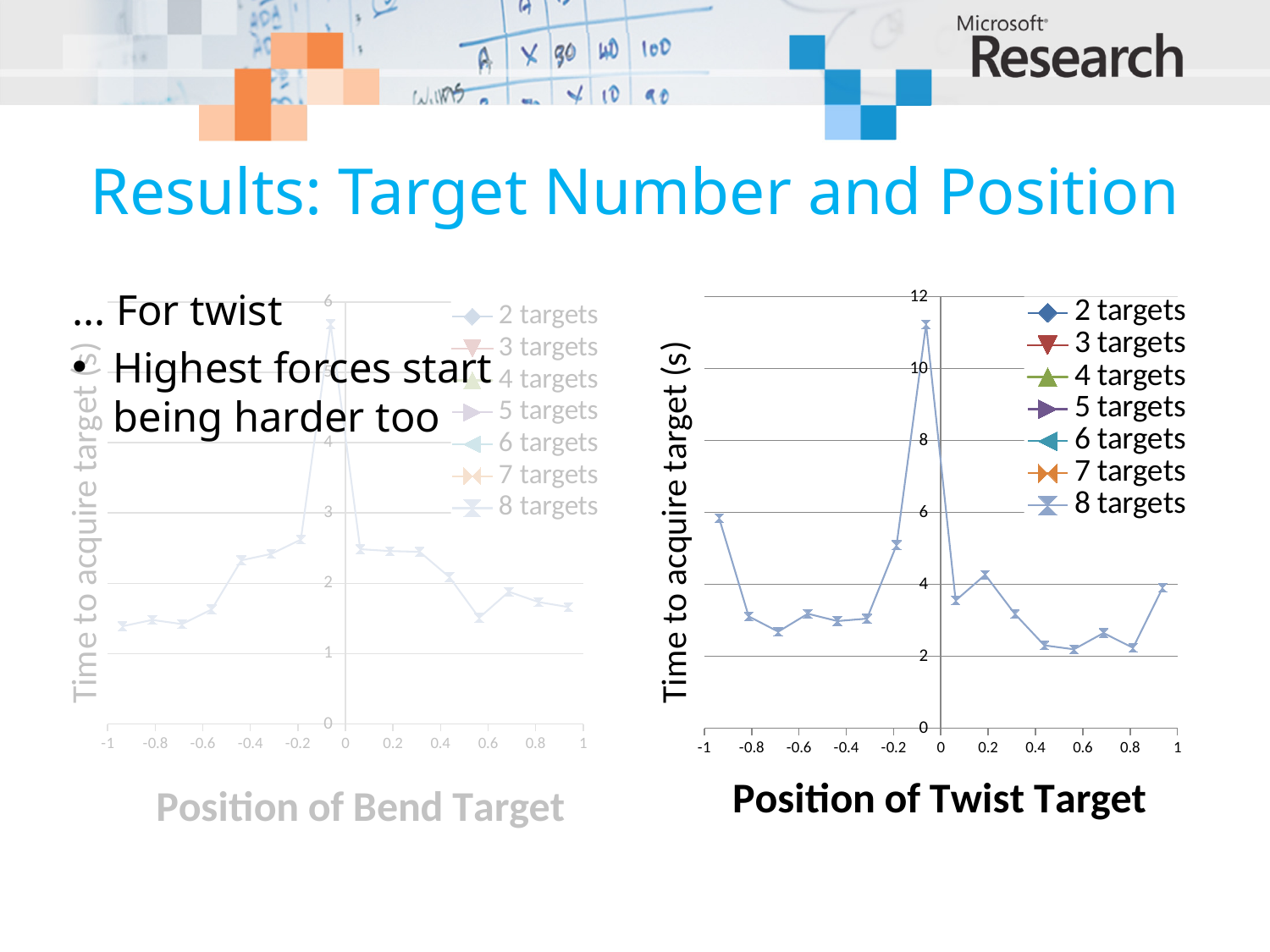
What type of chart is the 'Position of Twist Target' chart? line chart In the 'Position of Twist Target' chart, is the peak of the 8 targets line located to the left or to the right of x = 0? left In the 'Position of Twist Target' chart, is the value of the 8 targets line at x = 0.55 greater or less than 4? less How many series does the legend of the 'Position of Twist Target' chart list? 7 In the 'Position of Bend Target' chart, is the peak value of the 8 targets line greater or less than 5? greater What is the x-axis title of the chart on the left of the slide? Position of Bend Target In the 'Position of Twist Target' chart, which has the larger value on the 8 targets line: the point near x = -0.95 or the point near x = 0.05? the point near x = -0.95 In the 'Position of Twist Target' chart, is the peak value of the 8 targets line greater or less than 10? greater What is the y-axis title of the 'Position of Twist Target' chart? Time to acquire target (s) In the 'Position of Twist Target' chart, does the 8 targets line rise or fall between x = 0.2 and x = 0.55? fall